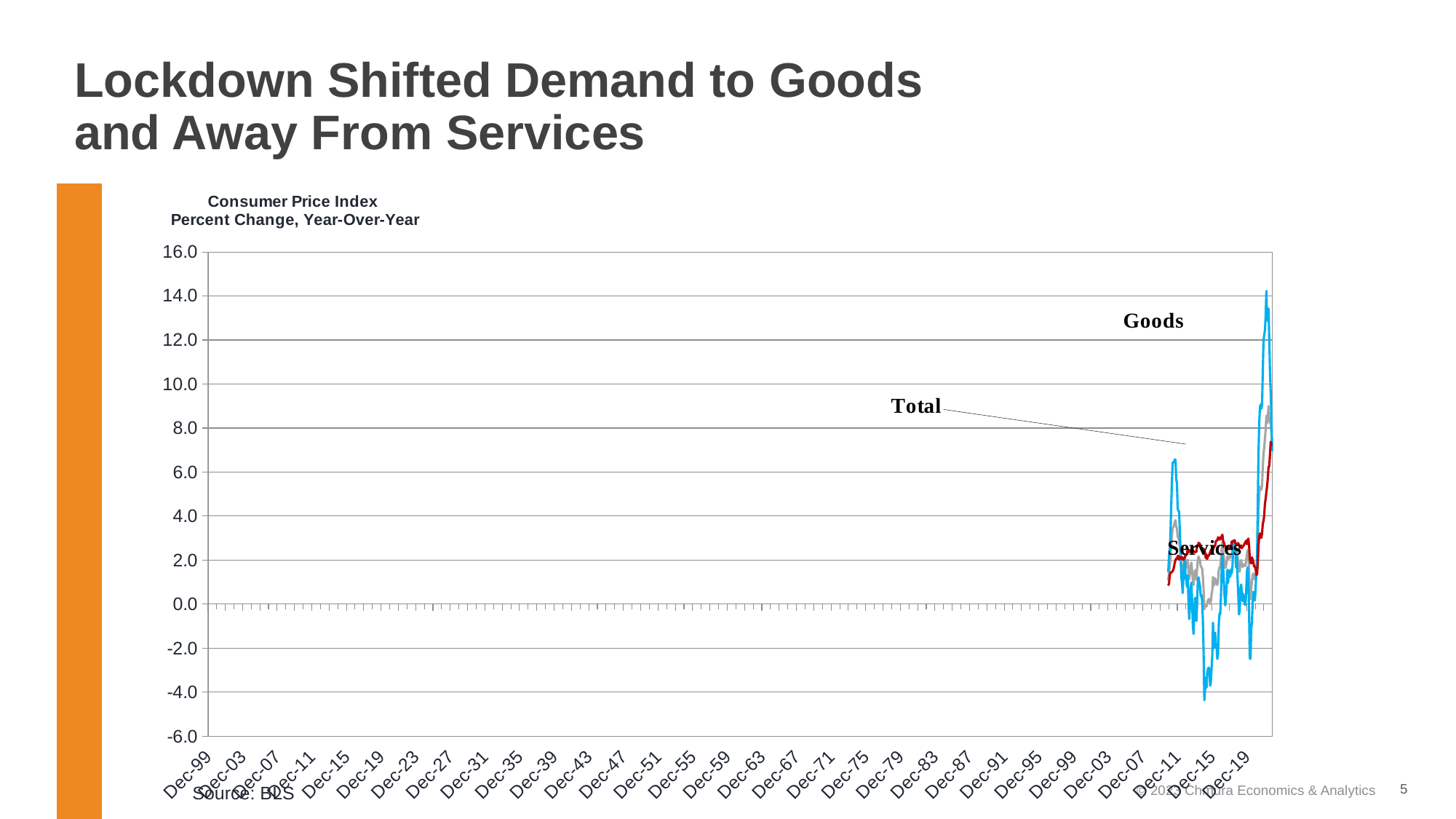
Which series reaches the highest value on the chart? Goods What is the title of the chart? Consumer Price Index Percent Change, Year-Over-Year Is the peak value of the Goods series greater or less than 12.0? greater Is the peak value of the Services series greater or less than 6.0? greater At their peaks, which series is larger, Goods or Services? Goods Do the Services values rise or fall toward the right end of the x axis? rise Is the lowest value of the Goods series greater or less than -2.0? less Which series falls to the lowest value on the chart? Goods What kind of chart is shown on the slide? line chart How many series are plotted on the chart? 3 What is the highest value shown on the y axis? 16.0